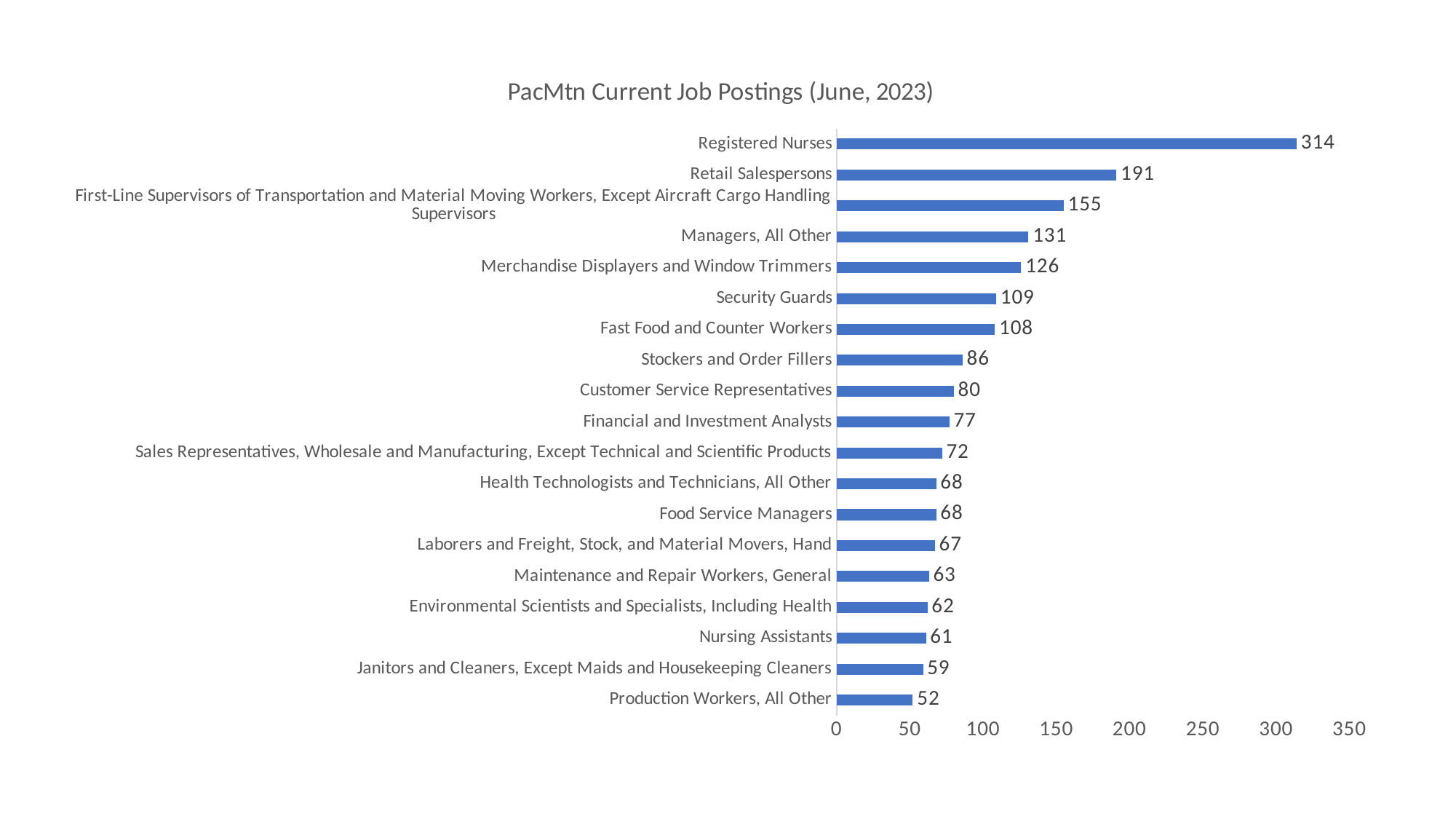
What is the title of the chart? PacMtn Current Job Postings (June, 2023) Which is larger, the value for Managers, All Other or the value for Merchandise Displayers and Window Trimmers? Managers, All Other What is the difference between the values for Registered Nurses and Retail Salespersons? 123 What is the value for Nursing Assistants? 61 What is the difference between the values for Stockers and Order Fillers and Customer Service Representatives? 6 What kind of chart is shown on the slide? Bar chart How many categories are shown in the chart? 19 Which category has the lowest value? Production Workers, All Other Is the value for Retail Salespersons greater or less than 200? less Which category has the highest value? Registered Nurses What is the value for Security Guards? 109 What is the value for Registered Nurses? 314